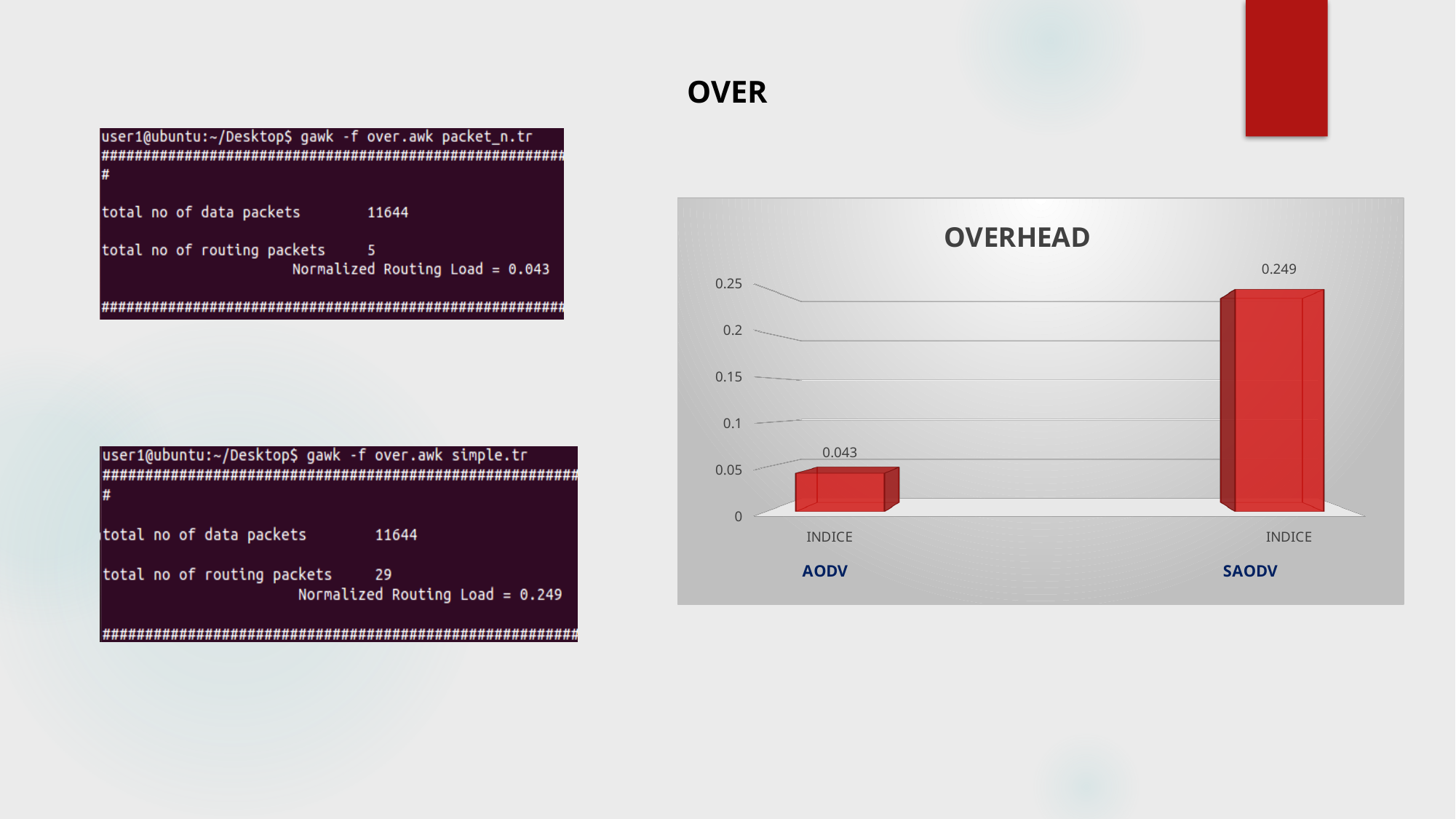
What is the title of the chart? OVERHEAD Is the value for AODV greater or less than 0.05? less How many bars are plotted in the chart? 2 Which protocol has the higher overhead value in the chart? SAODV What is the overhead value shown for AODV? 0.043 What kind of chart is shown on the slide? bar chart What is the highest tick value shown on the vertical axis? 0.25 What is the overhead value shown for SAODV? 0.249 Which protocol has the lower overhead value in the chart? AODV Is the overhead value for AODV larger or smaller than the value for SAODV? smaller What is the difference between the SAODV and AODV overhead values? 0.206 Is the value for SAODV greater or less than 0.2? greater